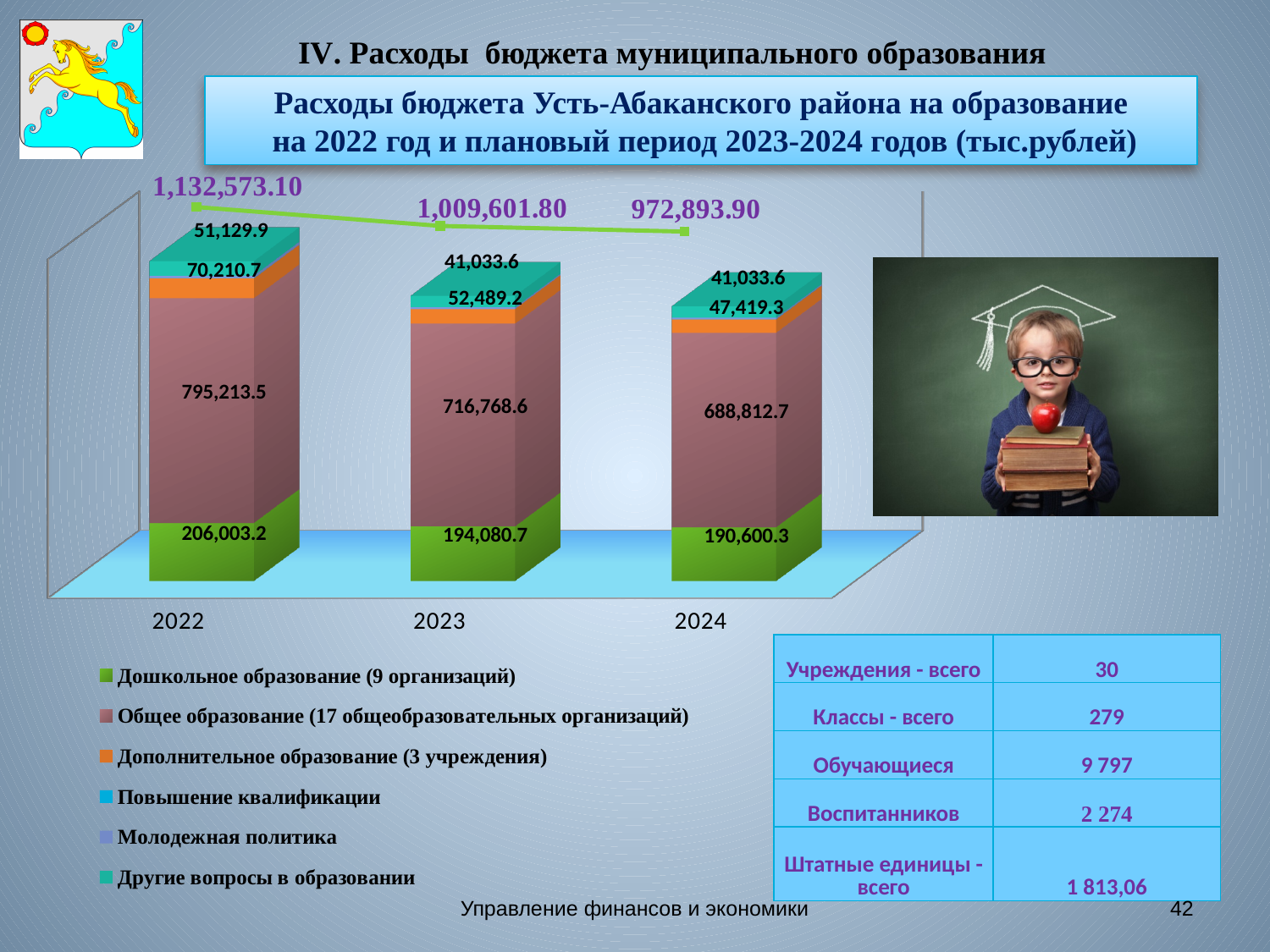
Which year has the highest value for Общее образование? 2022 What is the total education expenditure shown for 2024? 972,893.90 What is the value for Дополнительное образование in 2024? 47,419.3 How many years (categories) are shown on the x axis of the chart? 3 What kind of chart is shown on the slide? Stacked bar chart with a line Which year has the lowest value for Дошкольное образование? 2024 What is the value for Общее образование in 2023? 716,768.6 What is the difference between the Общее образование values for 2022 and 2023? 78,444.9 How many series does the chart legend list? 6 What is the value for Дошкольное образование in 2022? 206,003.2 What is the total education expenditure shown for 2022? 1,132,573.10 Do the total expenditure values rise or fall from 2022 to 2024? Fall